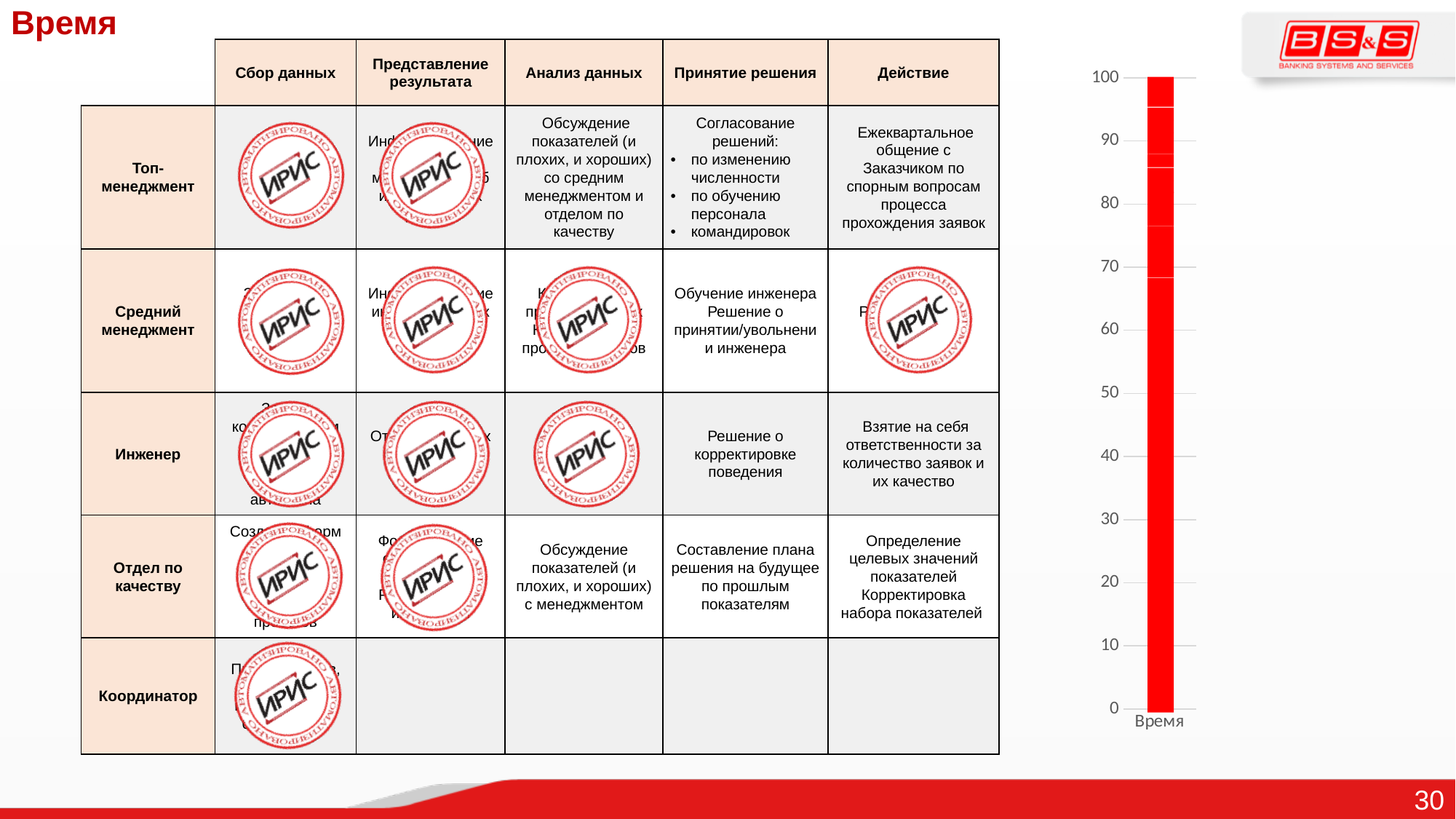
In the chart on the right, what is the total height of the bar for Время? 100 What is the label of the single category on the x axis of the chart on the right? Время What kind of chart is shown on the right side of the slide? bar chart What is the lowest value shown on the y axis of the chart on the right? 0 How many categories are plotted on the x axis of the chart on the right? 1 In the chart on the right, is the total height of the bar for Время greater or less than 90? greater What is the highest value shown on the y axis of the chart on the right? 100 In the chart on the right, is the total height of the bar for Время greater or less than 50? greater